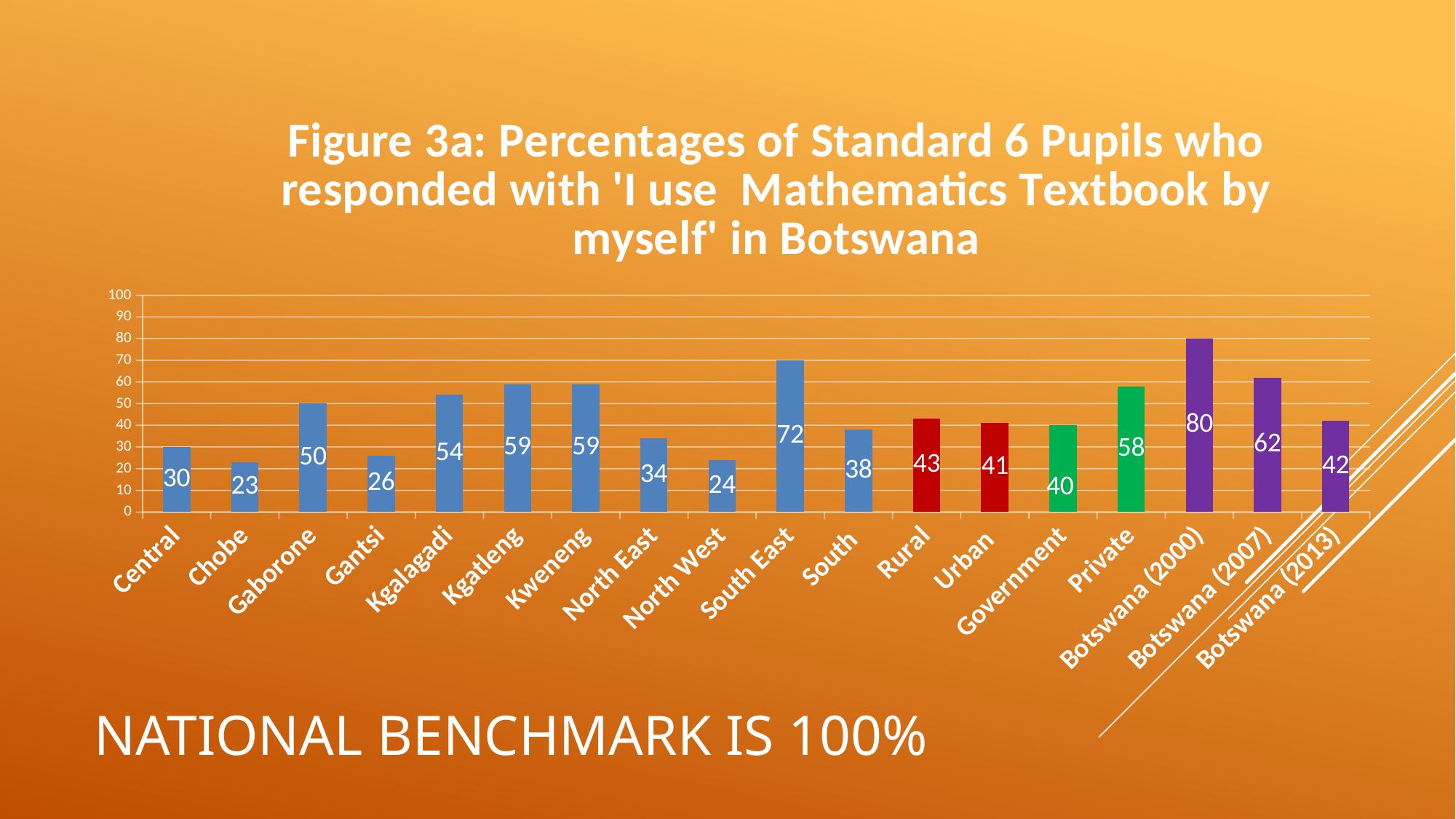
What is the difference between the values for Botswana (2000) and Botswana (2007)? 18 What is the value for South East? 72 Which is larger, the value for Gaborone or the value for Kgalagadi? Kgalagadi What kind of chart is shown on the slide? bar chart Is the value for North West greater or less than 30? less How many categories are shown on the x axis? 18 What is the value for Botswana (2013)? 42 Which category has the highest value? Botswana (2000) What is the national benchmark stated on the slide? 100% What is the difference between the values for Rural and Urban? 2 Which category has the lowest value? Chobe What is the value for Private? 58